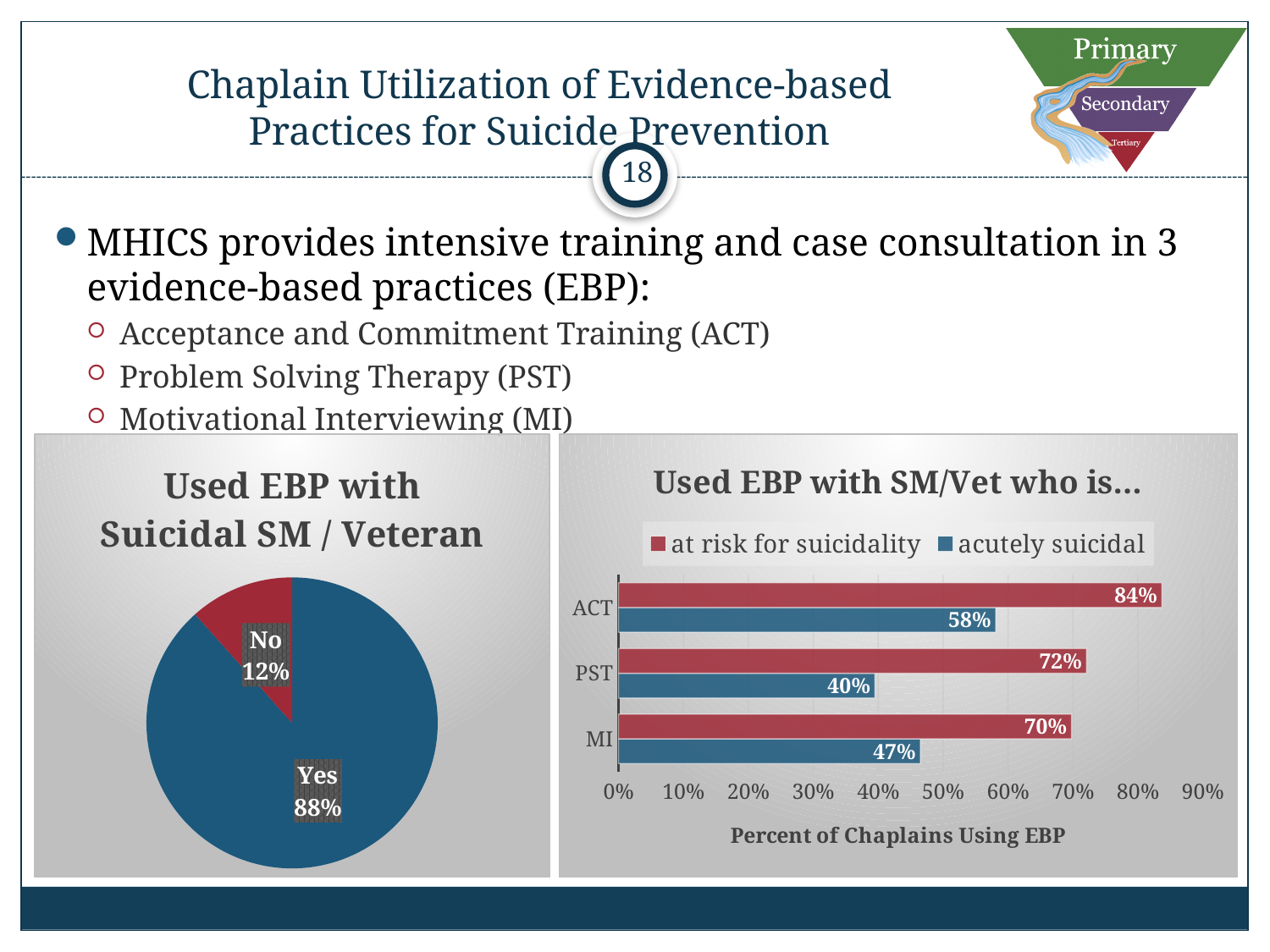
What kind of chart is the chart on the left titled 'Used EBP with Suicidal SM / Veteran'? pie chart In the bar chart 'Used EBP with SM/Vet who is...', which is larger: the 'acutely suicidal' value for MI or for PST? MI In the bar chart 'Used EBP with SM/Vet who is...', which practice has the lowest value in the 'acutely suicidal' series? PST In the bar chart 'Used EBP with SM/Vet who is...', which practice has the highest value in the 'at risk for suicidality' series? ACT In the bar chart 'Used EBP with SM/Vet who is...', what is the value for MI in the 'acutely suicidal' series? 47% In the bar chart 'Used EBP with SM/Vet who is...', what is the difference between the 'at risk for suicidality' and 'acutely suicidal' values for ACT? 26% In the bar chart 'Used EBP with SM/Vet who is...', what is the value for ACT in the 'at risk for suicidality' series? 84% In the pie chart 'Used EBP with Suicidal SM / Veteran', what percentage answered Yes? 88% In the bar chart 'Used EBP with SM/Vet who is...', what is the value for PST in the 'acutely suicidal' series? 40% In the pie chart 'Used EBP with Suicidal SM / Veteran', what percentage answered No? 12% How many series does the legend of the bar chart 'Used EBP with SM/Vet who is...' list? 2 What is the x-axis title of the bar chart 'Used EBP with SM/Vet who is...'? Percent of Chaplains Using EBP